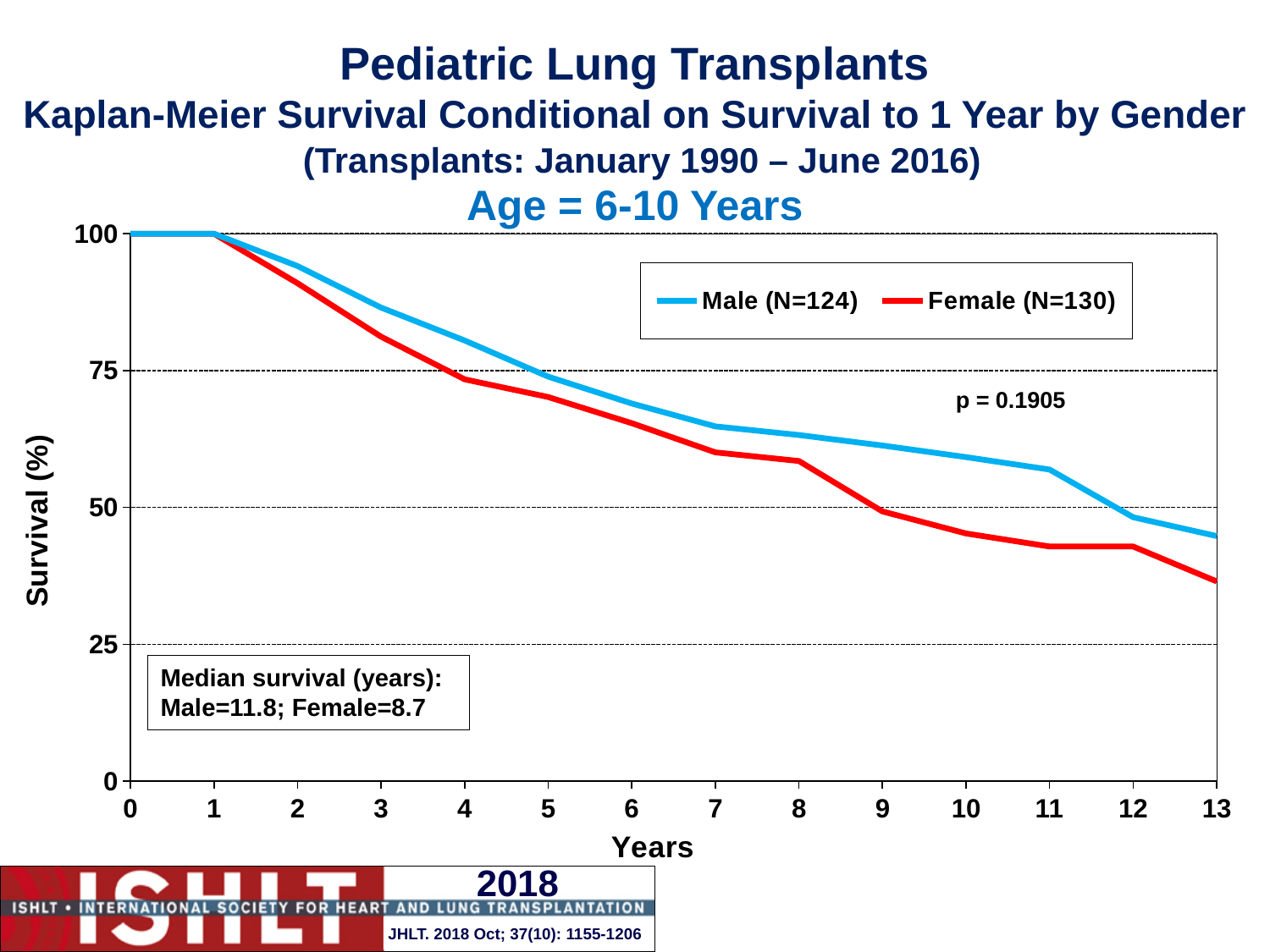
Do the survival curves rise or fall as years increase? fall What is the median survival in years for females, as printed on the slide? 8.7 What p-value is printed on the chart? p = 0.1905 Is the Female survival value at 13 years greater or less than 50? less At 13 years, which curve shows higher survival, Male or Female? Male Which group has the larger N in the legend, Male or Female? Female Is the Male survival value at 7 years greater or less than 50? greater How many series does the legend list? 2 What is the median survival in years for males, as printed on the slide? 11.8 Is the Female survival value at 2 years greater or less than 75? greater What kind of chart is shown on the slide? line chart What are the two series named in the legend? Male (N=124) and Female (N=130)